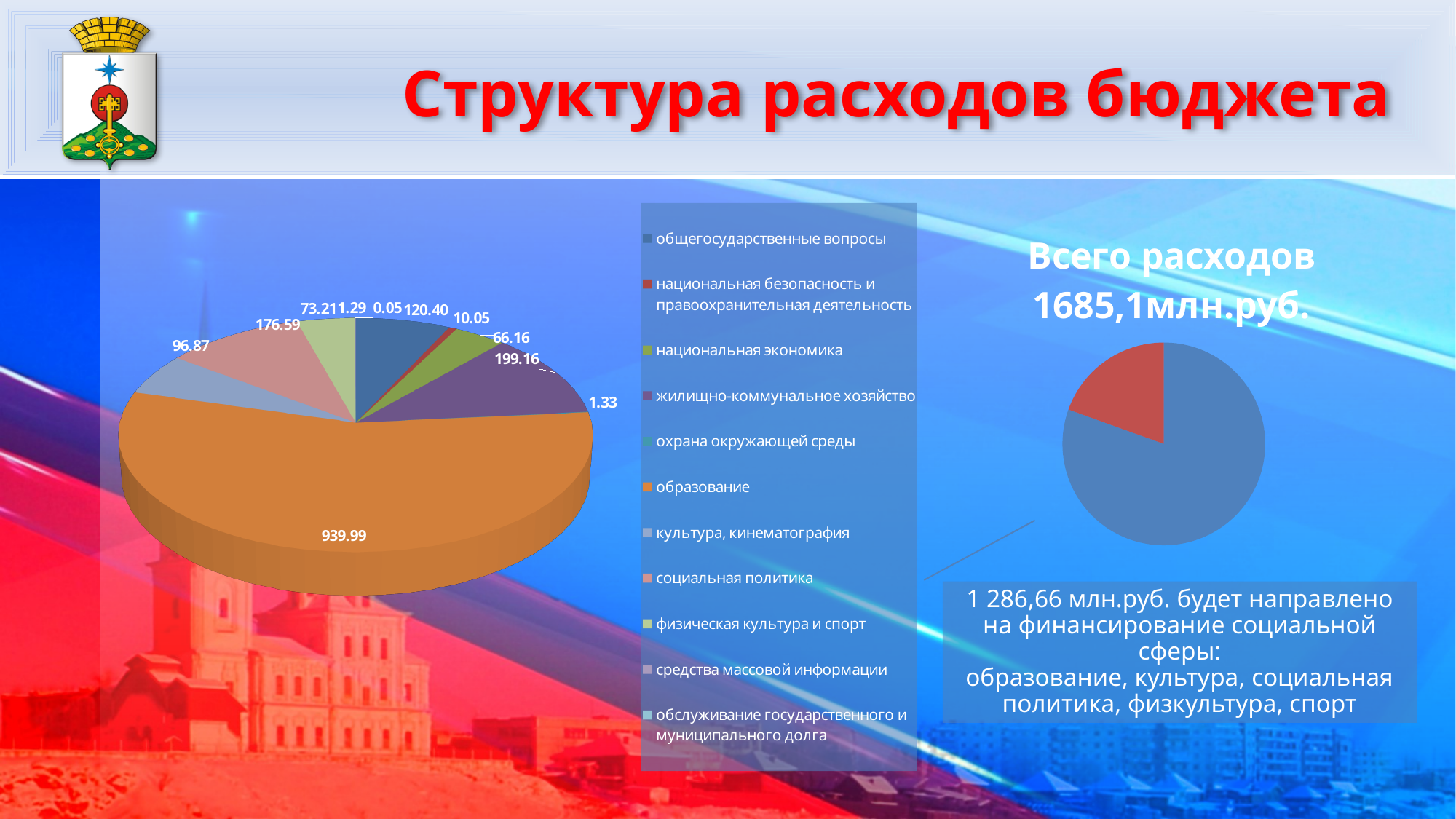
In the large pie chart, what is the difference between the values for образование and жилищно-коммунальное хозяйство? 740.83 What kind of chart is the large chart on the left of the slide? pie chart In the large pie chart, what is the value for общегосударственные вопросы? 120.40 In the large pie chart, what is the value for жилищно-коммунальное хозяйство? 199.16 How many categories does the legend of the large pie chart list? 11 In the large pie chart, what is the value for образование? 939.99 In the large pie chart, what is the value for социальная политика? 176.59 What is the title of the slide containing the pie charts? Структура расходов бюджета In the large pie chart, what is the value for культура, кинематография? 96.87 In the large pie chart, which category has the smallest value? обслуживание государственного и муниципального долга In the large pie chart, which is larger: социальная политика or национальная экономика? социальная политика In the large pie chart, which category has the largest slice? образование